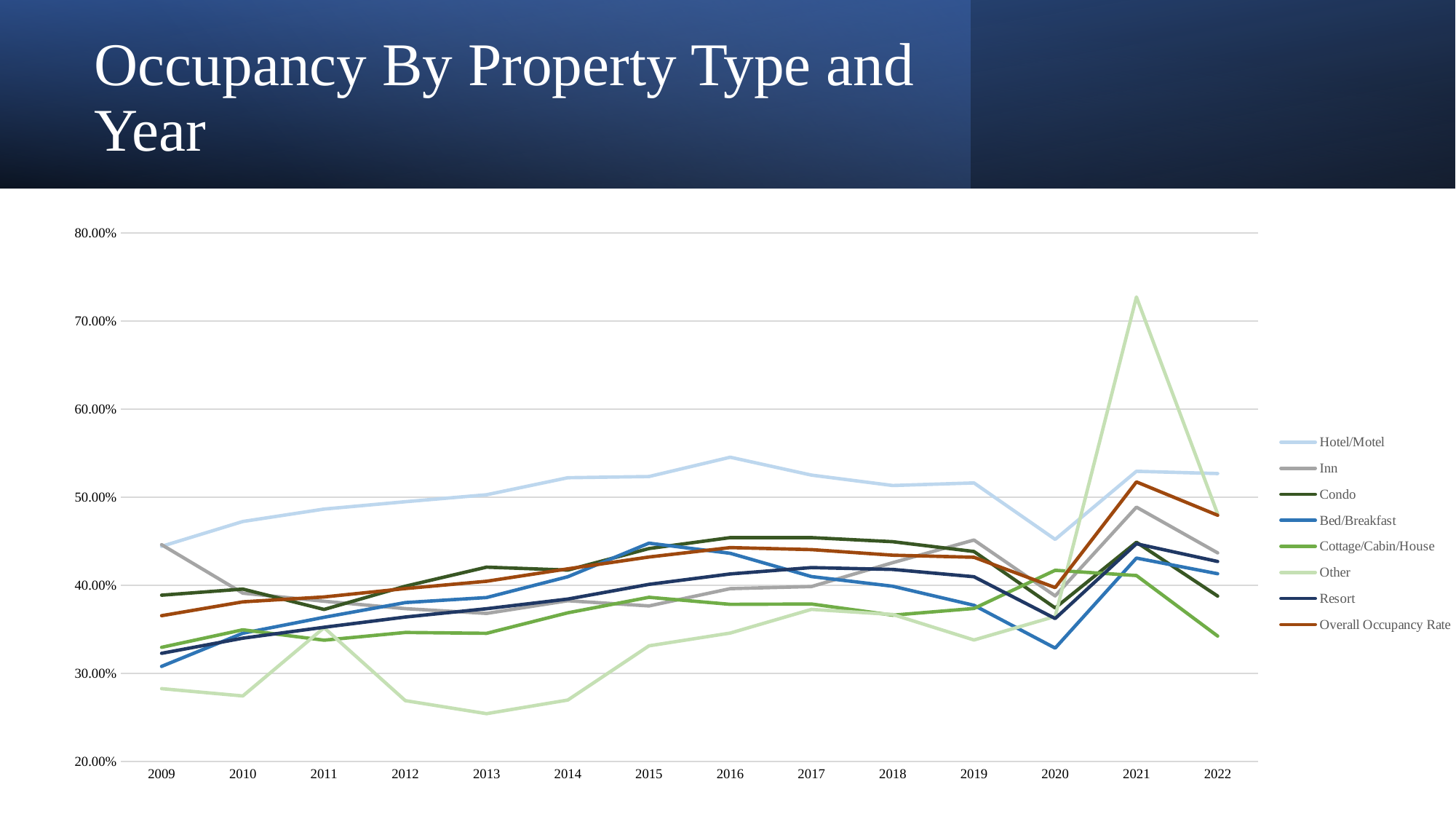
Is the value for Hotel/Motel in 2016 greater or less than 50.00%? greater Is the value for Other in 2021 greater or less than 70.00%? greater Which series has the highest value in 2021? Other How many years are shown along the x axis? 14 What kind of chart is shown on the slide? line chart Is the value for Other in 2013 greater or less than 30.00%? less What is the title of the chart on the slide? Occupancy By Property Type and Year In which year does the Other series reach its highest value? 2021 How many series does the legend list? 8 Which is larger in 2022, the value for Condo or the value for Cottage/Cabin/House? Condo Does the Hotel/Motel series rise or fall from 2009 to 2016? rise Which series has the lowest value in 2009? Other